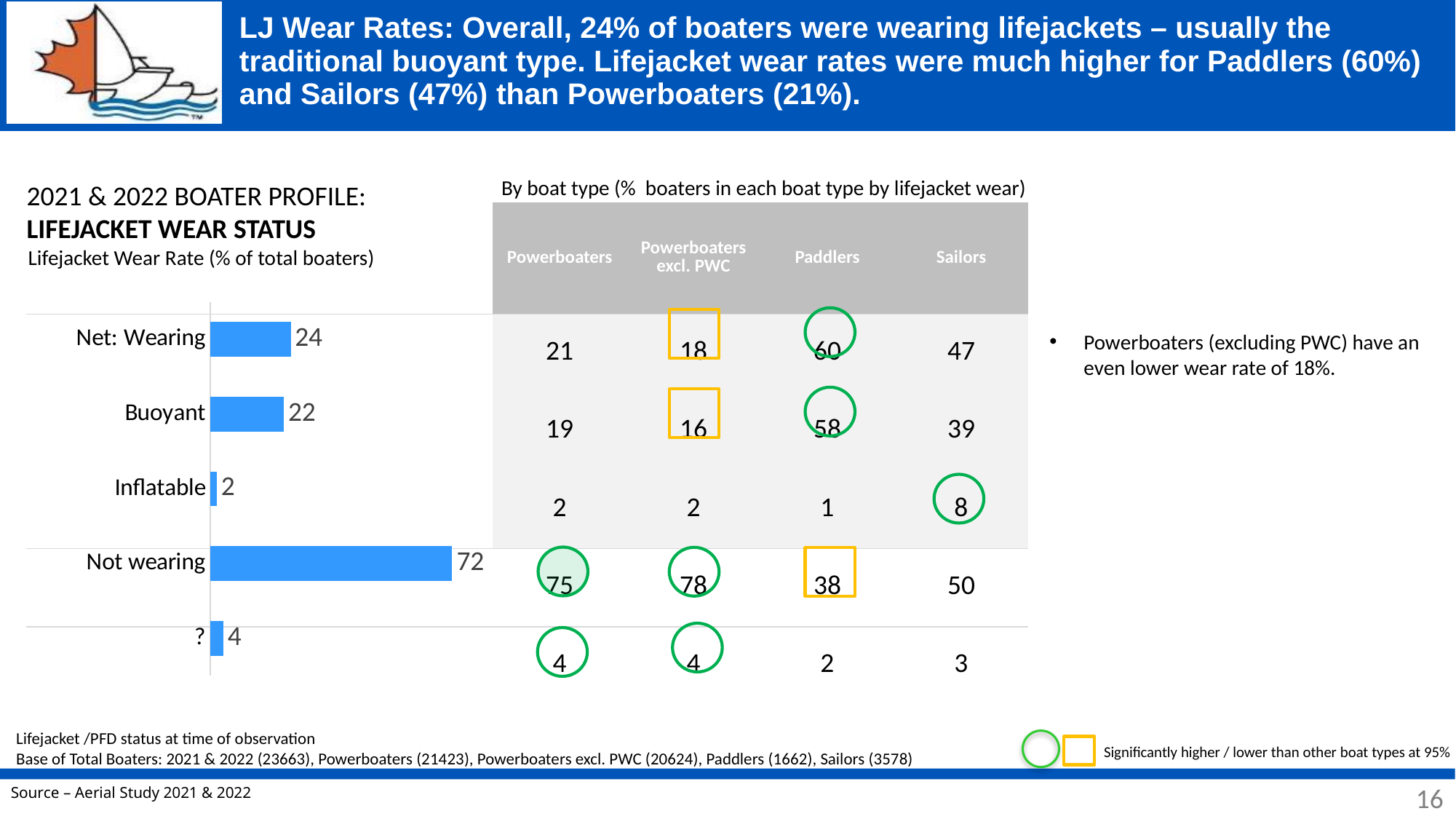
How many bars are plotted in the Lifejacket Wear Rate bar chart? 5 What is the difference between the Not wearing and Net: Wearing values in the Lifejacket Wear Rate bar chart? 48 What is the value for Buoyant in the Lifejacket Wear Rate bar chart? 22 What kind of chart is the Lifejacket Wear Rate chart? Bar chart What is the value for Not wearing in the Lifejacket Wear Rate bar chart? 72 Which category has the highest value in the Lifejacket Wear Rate bar chart? Not wearing What is the value for Net: Wearing in the Lifejacket Wear Rate bar chart? 24 What is the difference between the Net: Wearing and Buoyant values in the Lifejacket Wear Rate bar chart? 2 Which category has the lowest value in the Lifejacket Wear Rate bar chart? Inflatable What is the value for Inflatable in the Lifejacket Wear Rate bar chart? 2 What is the subtitle printed above the Lifejacket Wear Rate bar chart, in bold? LIFEJACKET WEAR STATUS In the Lifejacket Wear Rate bar chart, which is larger: Buoyant or Inflatable? Buoyant